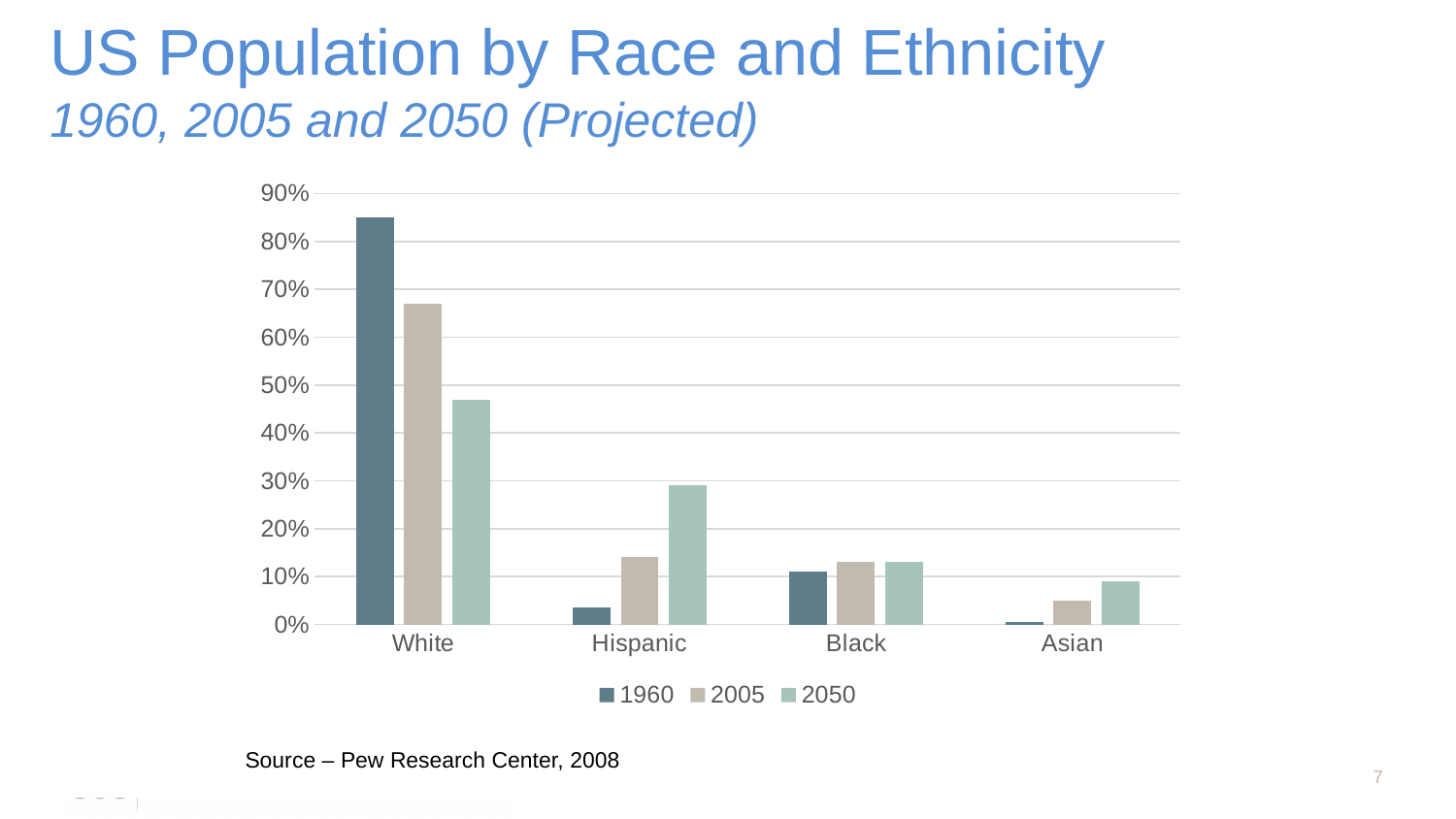
Which is larger for 2050, the value for Hispanic or the value for Black? Hispanic What source is cited below the chart? Pew Research Center, 2008 Is the value for Hispanic in 2050 greater or less than 20%? greater Do the values for White rise or fall from 1960 to 2005 to 2050? fall What kind of chart is shown on the slide? bar chart Which category has the lowest value for 1960? Asian Which category has the highest value for 1960? White Is the value for White in 1960 greater or less than 80%? greater How many race/ethnicity categories are shown on the x axis? 4 Is the value for White in 2050 greater or less than 50%? less How many series does the legend list? 3